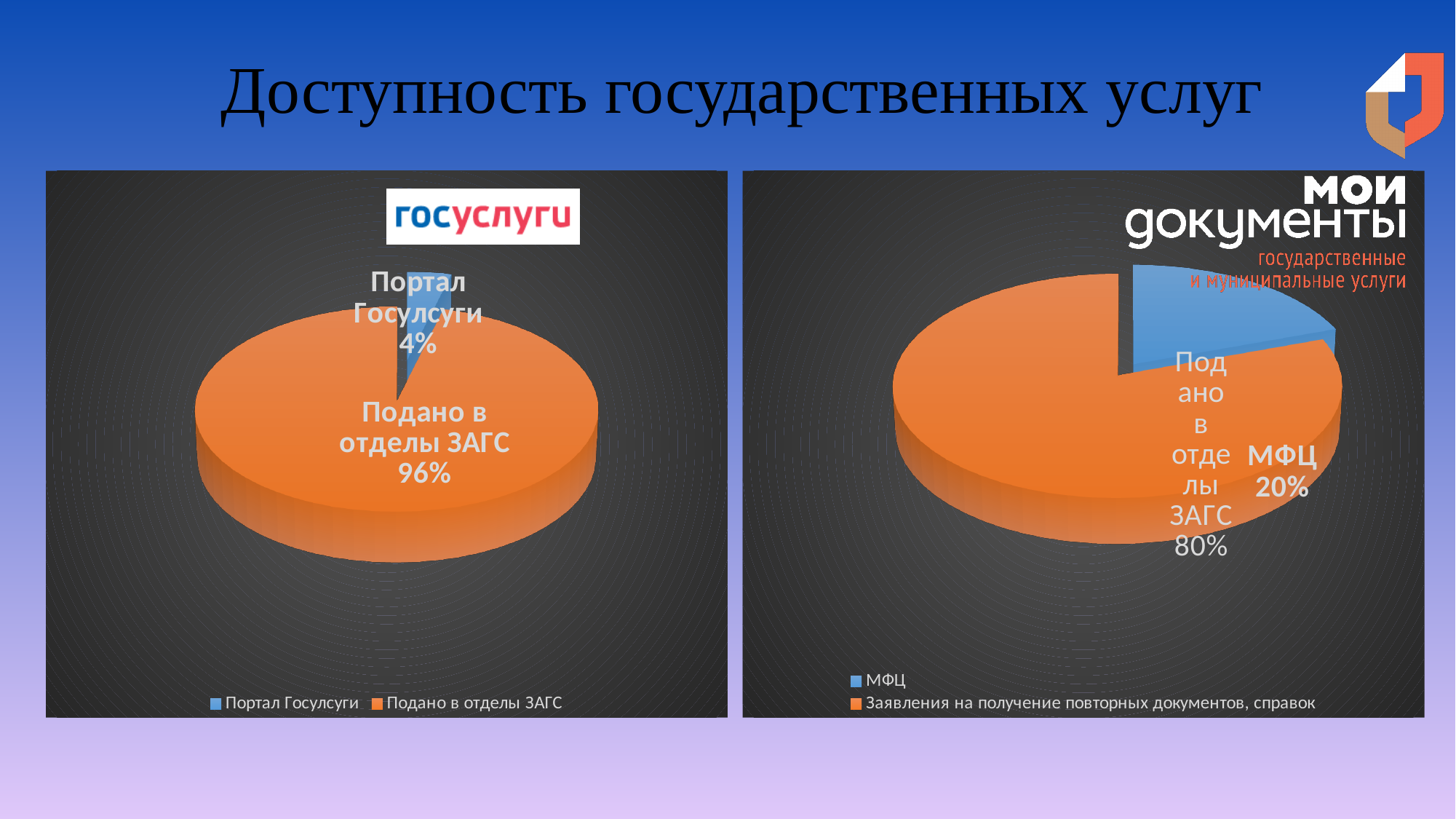
How many slices does the right pie chart have? 2 How many entries does the legend of the left pie chart list? 2 On the right pie chart, which is larger: МФЦ or Подано в отделы ЗАГС? Подано в отделы ЗАГС On the left pie chart, what share is labelled for Подано в отделы ЗАГС? 96% On the right pie chart, which slice is the smallest? МФЦ What type of chart is shown on the left side of the slide? Pie chart On the left pie chart, which slice is the largest? Подано в отделы ЗАГС On the right pie chart, what is the difference in percentage points between Подано в отделы ЗАГС and МФЦ? 60 On the left pie chart, what share is labelled for Портал Госулсуги? 4% On the right pie chart, what share is labelled for Подано в отделы ЗАГС? 80% On the left pie chart, what is the difference in percentage points between Подано в отделы ЗАГС and Портал Госулсуги? 92 On the right pie chart, what share is labelled for МФЦ? 20%